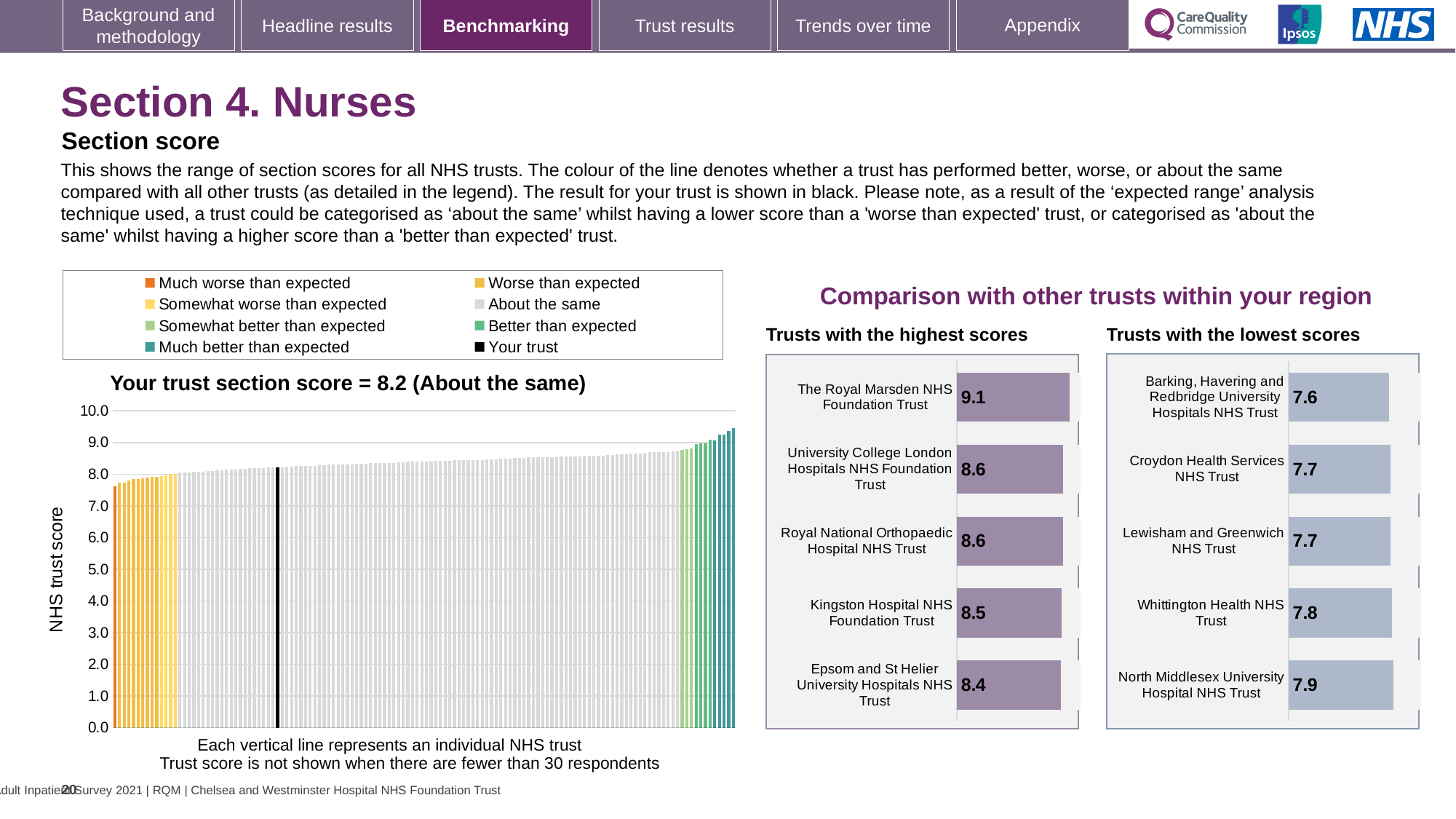
What kind of chart is the main section score chart on the left? bar chart In the 'Trusts with the highest scores' chart, which trust has the highest score? The Royal Marsden NHS Foundation Trust In the 'Trusts with the highest scores' chart, how many trusts are listed? 5 How many entries does the legend above the main section score chart list? 8 In the 'Trusts with the highest scores' chart, what is the score for The Royal Marsden NHS Foundation Trust? 9.1 In the 'Trusts with the lowest scores' chart, which has the larger score: Whittington Health NHS Trust or North Middlesex University Hospital NHS Trust? North Middlesex University Hospital NHS Trust In the 'Trusts with the lowest scores' chart, which trust has the lowest score? Barking, Havering and Redbridge University Hospitals NHS Trust In the main section score chart on the left, what is the section score for your trust? 8.2 In the 'Trusts with the lowest scores' chart, what is the score for Croydon Health Services NHS Trust? 7.7 In the 'Trusts with the highest scores' chart, what is the difference between the scores of The Royal Marsden NHS Foundation Trust and Epsom and St Helier University Hospitals NHS Trust? 0.7 In the main section score chart on the left, do the bar values rise or fall from left to right? rise In the main section score chart on the left, is the value of the lowest bar greater or less than 8.0? less